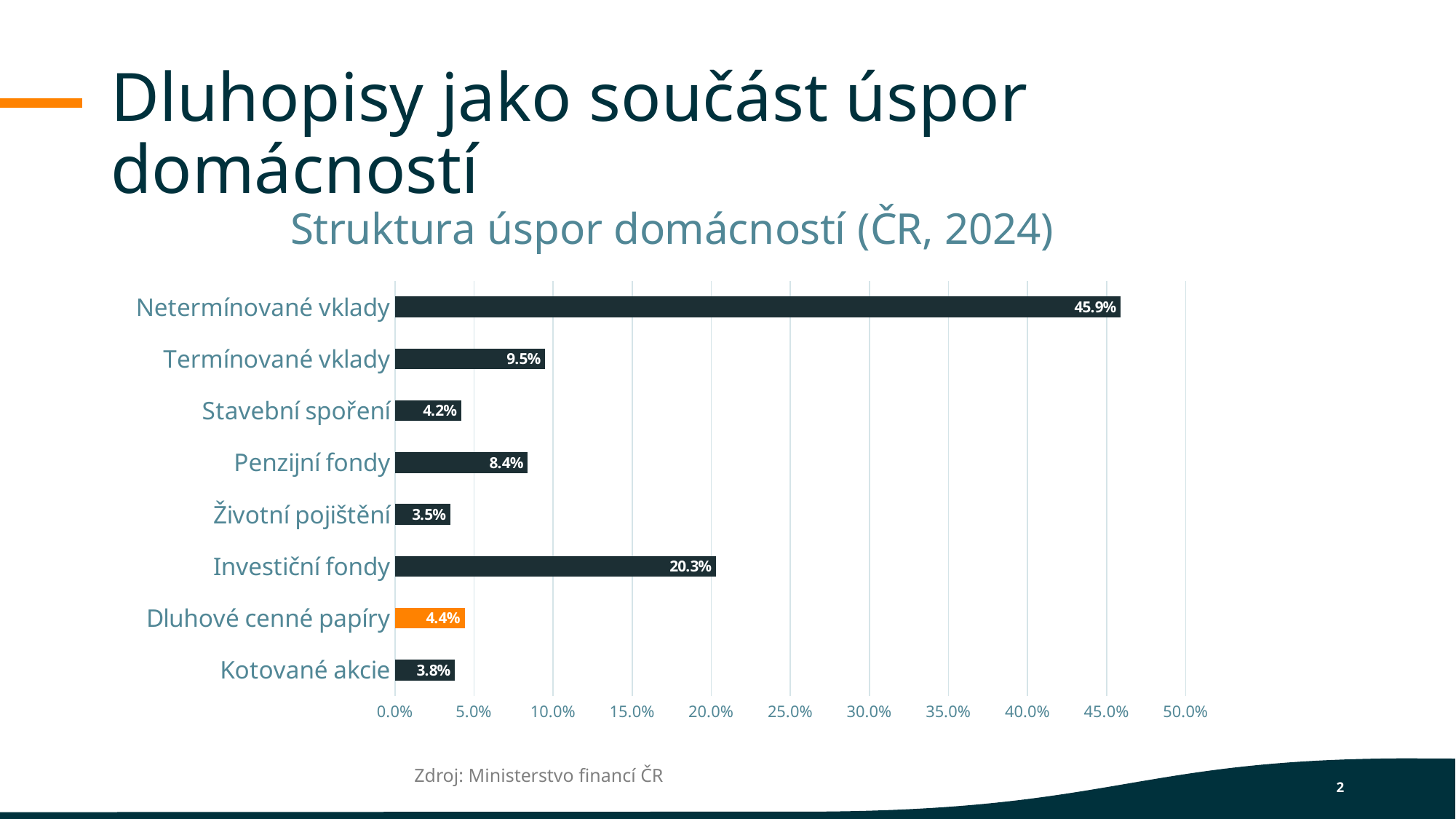
What is the value for Netermínované vklady? 45.9% Which category has the highest value? Netermínované vklady Which is larger, Stavební spoření or Dluhové cenné papíry? Dluhové cenné papíry What is the difference between Termínované vklady and Penzijní fondy? 1.1% Is the value for Investiční fondy greater or less than 20.0%? greater What kind of chart is shown on the slide? Bar chart Which category has the lowest value? Životní pojištění What is the value for Dluhové cenné papíry? 4.4% What is the value for Investiční fondy? 20.3% Which category's bar is highlighted in orange? Dluhové cenné papíry How many categories are shown in the chart? 8 What is the title of the chart? Struktura úspor domácností (ČR, 2024)